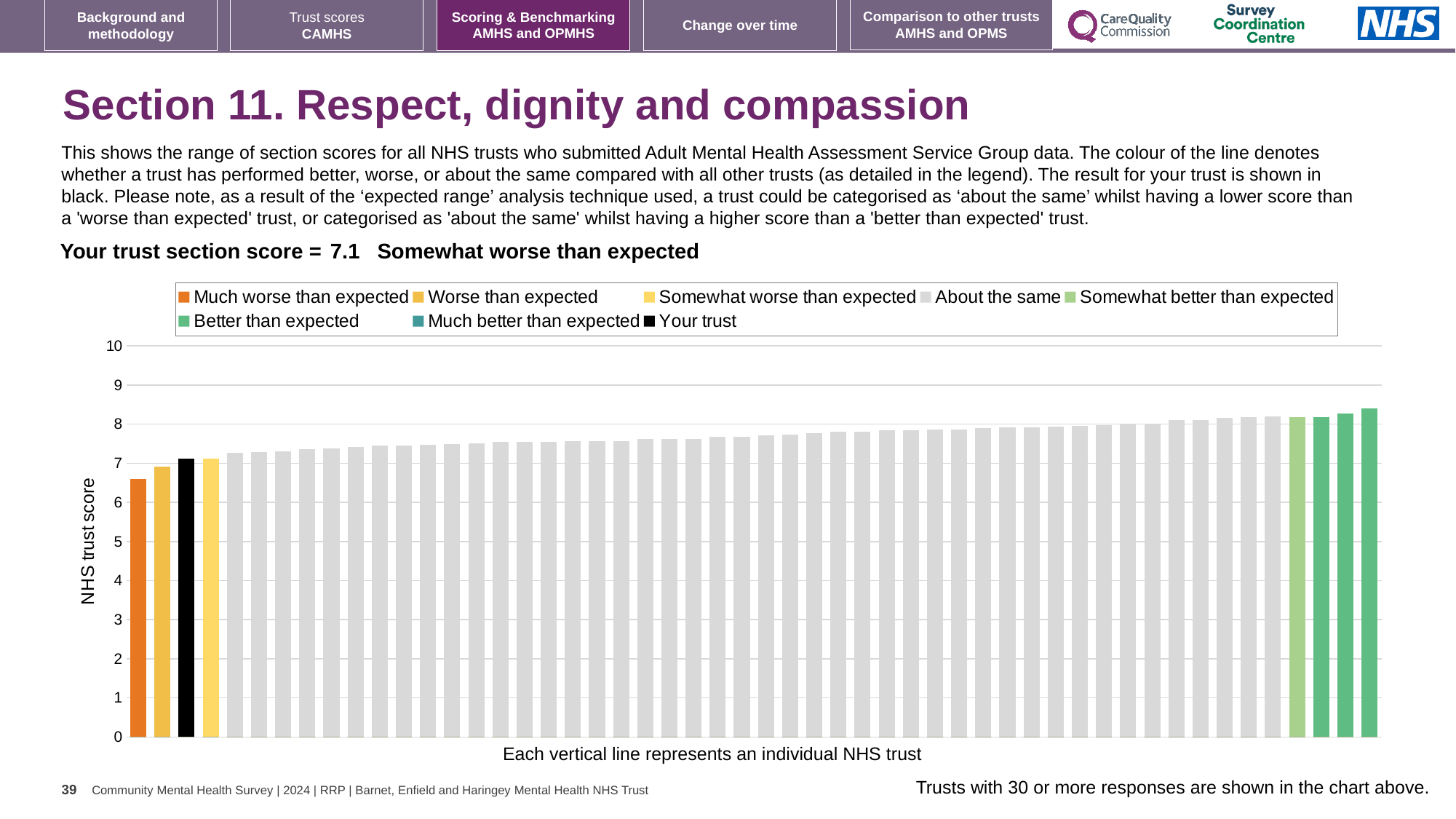
Is the value of the rightmost bar greater or less than 8? greater Which category does your trust's section score fall into, according to the slide? Somewhat worse than expected How many entries does the chart legend list? 8 What colour is the bar representing your trust? black Do the bar values rise or fall from left to right along the x axis? rise What is the section score for your trust shown on the slide? 7.1 Which is larger: the value of the black 'Your trust' bar or the value of the rightmost bar? the rightmost bar Is the value of the leftmost (orange) bar greater or less than 7? less What is the label on the vertical axis of the chart? NHS trust score What kind of chart is shown on the slide? bar chart Is the value for your trust (black bar) greater or less than 8? less Which legend category does the lowest bar in the chart belong to? Much worse than expected